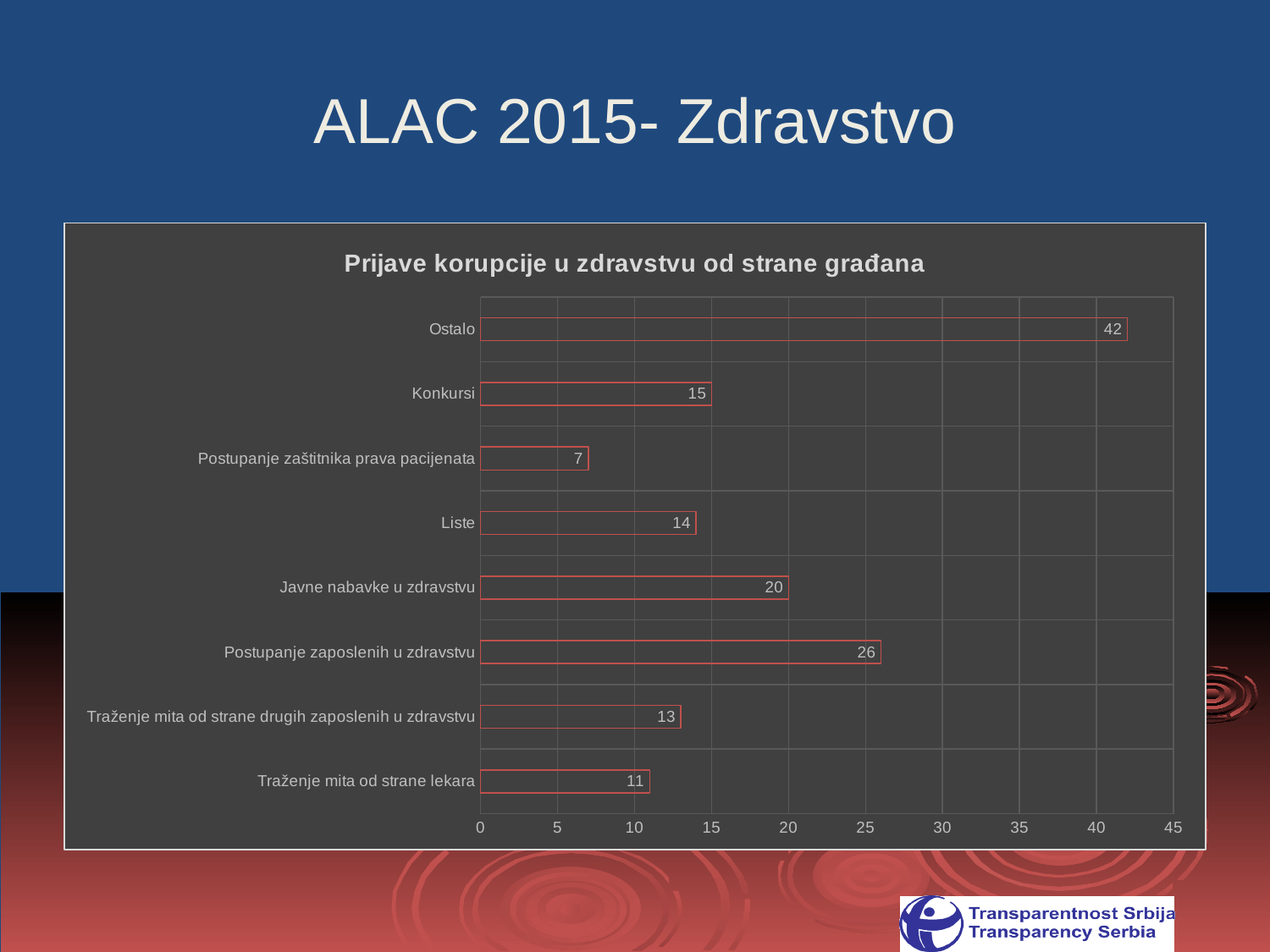
What is the value for Traženje mita od strane lekara? 11 What is the value for Ostalo? 42 What is the difference between the values for Postupanje zaposlenih u zdravstvu and Konkursi? 11 How many categories are shown in the chart? 8 Which category has the lowest value? Postupanje zaštitnika prava pacijenata What is the title of the chart? Prijave korupcije u zdravstvu od strane građana Is the value for Postupanje zaposlenih u zdravstvu greater or less than 25? greater What is the maximum value shown on the x axis? 45 What is the value for Javne nabavke u zdravstvu? 20 Which is larger, the value for Liste or the value for Traženje mita od strane drugih zaposlenih u zdravstvu? Liste Which category has the highest value? Ostalo What kind of chart is shown on the slide? bar chart